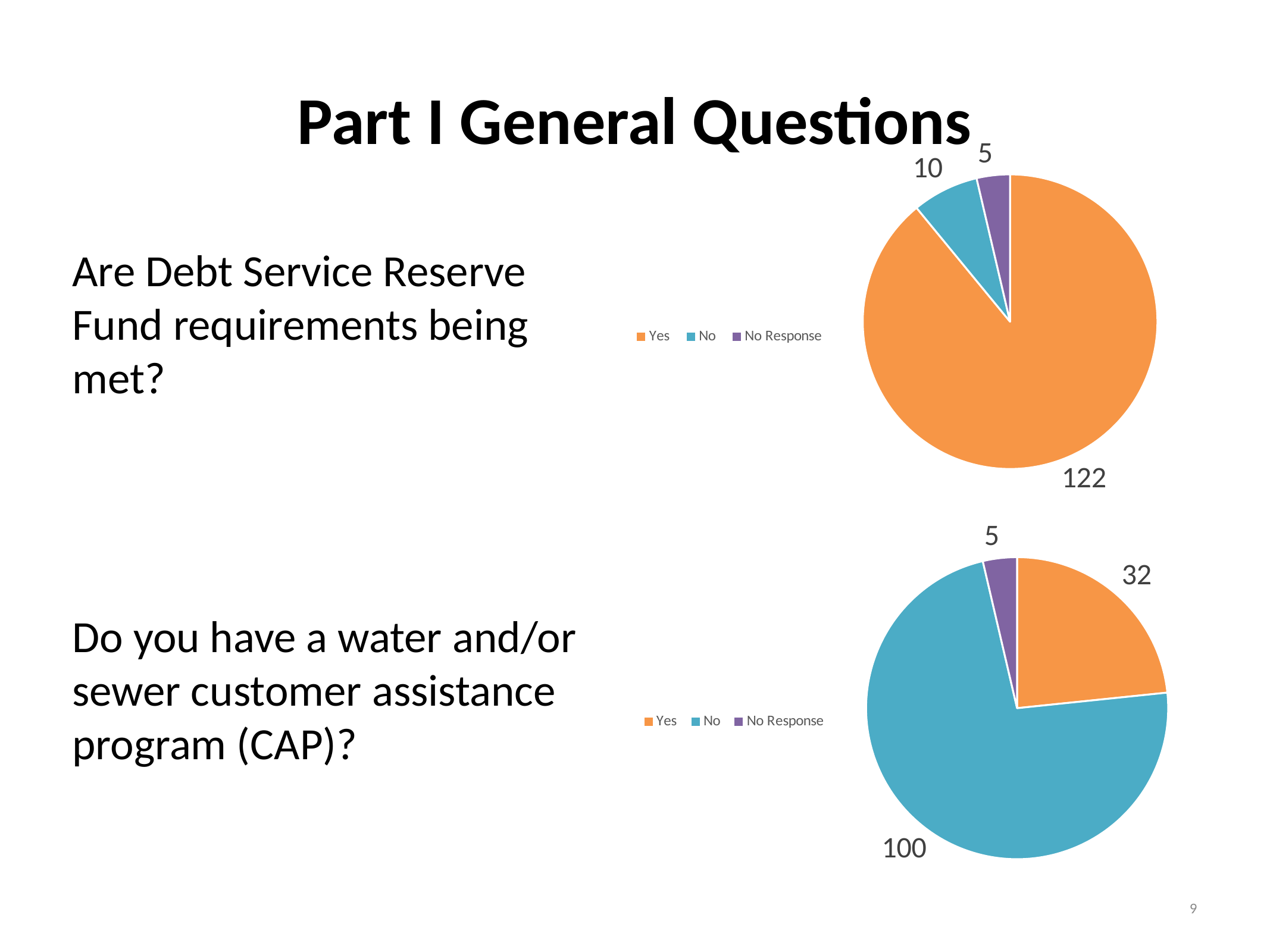
In the bottom pie chart (customer assistance program), which is larger, Yes or No? No In the top pie chart (Debt Service Reserve Fund requirements), what is the value for Yes? 122 What are the legend entries of the bottom pie chart (customer assistance program)? Yes, No, No Response In the bottom pie chart (customer assistance program), which category has the smallest slice? No Response In the top pie chart (Debt Service Reserve Fund requirements), which category has the largest slice? Yes In the bottom pie chart (customer assistance program), what is the difference between the No and Yes values? 68 How many slices does the top pie chart (Debt Service Reserve Fund requirements) have? 3 In the top pie chart (Debt Service Reserve Fund requirements), what is the difference between the Yes and No values? 112 What type of chart is used for the customer assistance program question? Pie chart In the bottom pie chart (customer assistance program), what is the value for No? 100 In the bottom pie chart (customer assistance program), what is the value for Yes? 32 In the top pie chart (Debt Service Reserve Fund requirements), what is the value for No? 10